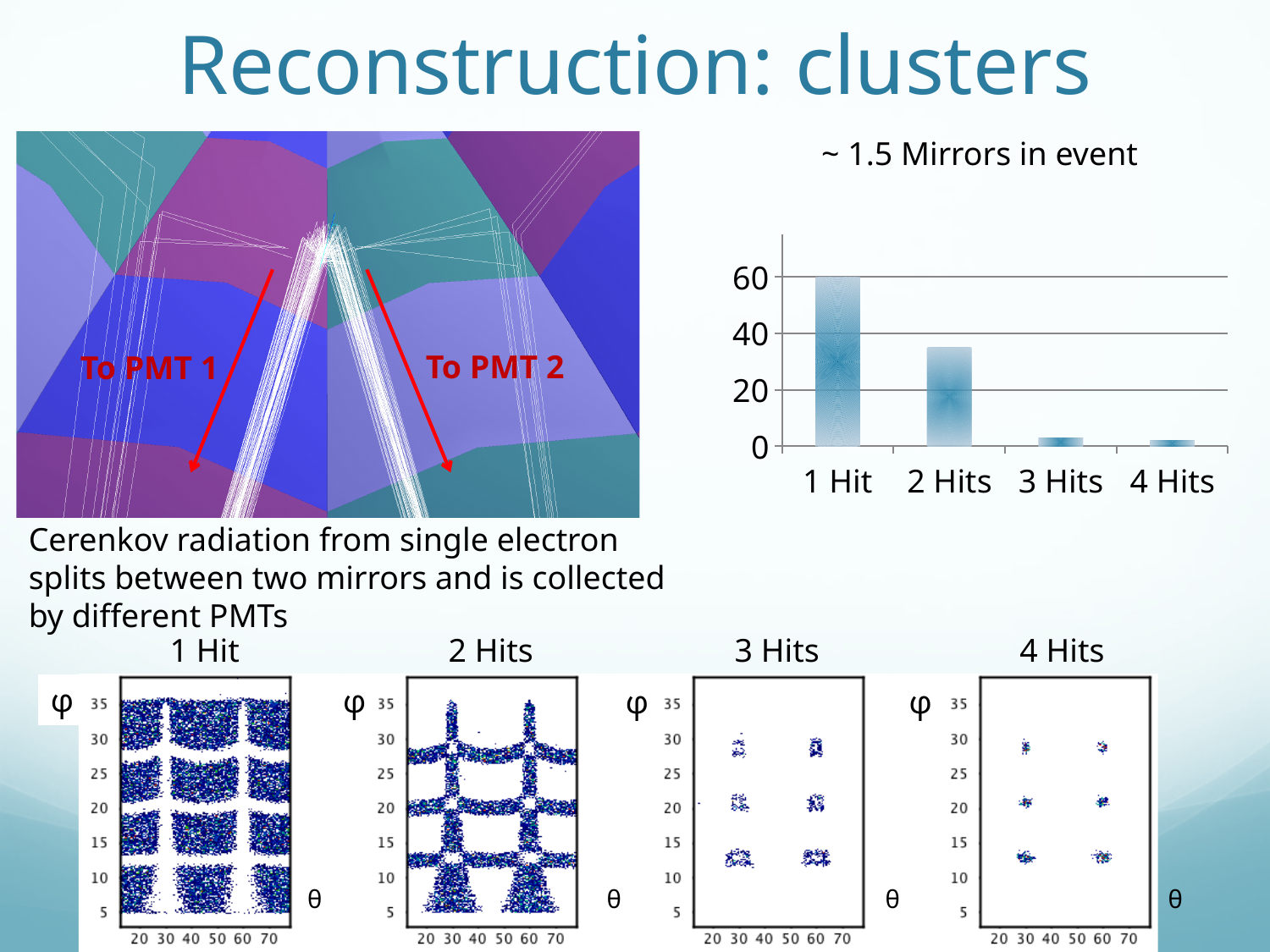
What is the highest tick value shown on the y axis of the bar chart? 60 In the bar chart, how many categories are shown on the x axis? 4 In the bar chart, which category has the highest value? 1 Hit In the bar chart, is the value for 1 Hit greater or less than 40? greater In the bar chart, which is larger, the value for 2 Hits or the value for 3 Hits? 2 Hits In the bar chart, do the values rise or fall from 1 Hit to 4 Hits? fall In the bar chart, is the value for 3 Hits greater or less than 20? less What text appears above the bar chart? ~ 1.5 Mirrors in event What kind of chart is shown in the upper right of the slide? bar chart In the bar chart, which is larger, the value for 1 Hit or the value for 2 Hits? 1 Hit In the bar chart, is the value for 2 Hits greater or less than 40? less